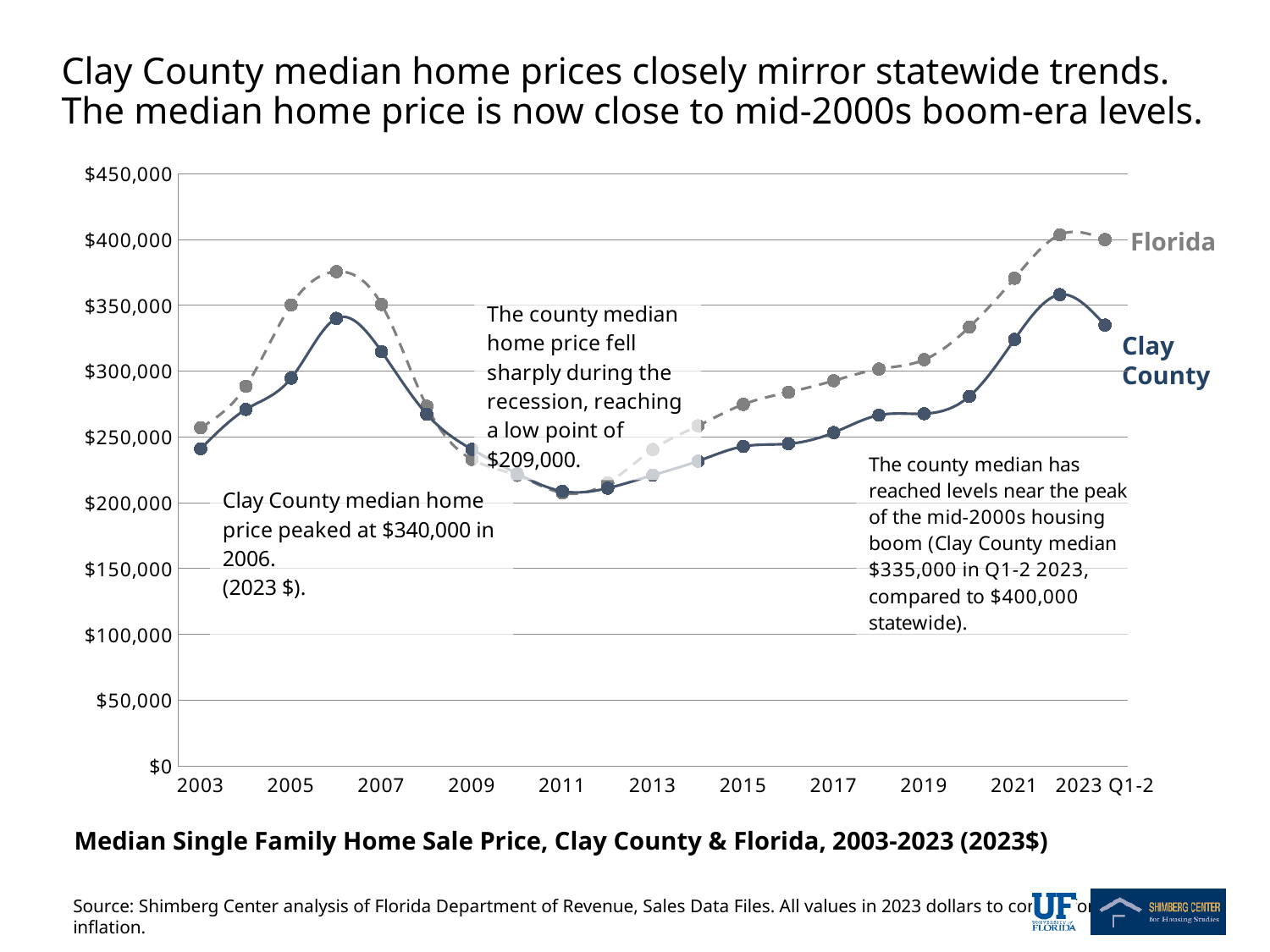
What was the Florida statewide median home price in Q1-2 2023? $400,000 Is the Florida median home price in 2006 greater or less than $350,000? greater What was the Clay County median home price at its 2006 peak? $340,000 In Q1-2 2023, which series has the higher median home price, Florida or Clay County? Florida In which year does the Clay County series reach its lowest value? 2011 How much higher was the Florida median than the Clay County median in Q1-2 2023? $65,000 What low point did the Clay County median home price reach during the recession? $209,000 How many series are plotted on the chart? 2 Is the Clay County median home price in 2011 greater or less than $250,000? less What kind of chart is shown on the slide? Line chart Between 2011 and 2022, does the Clay County median home price generally rise or fall? Rise What was the Clay County median home price in Q1-2 2023? $335,000